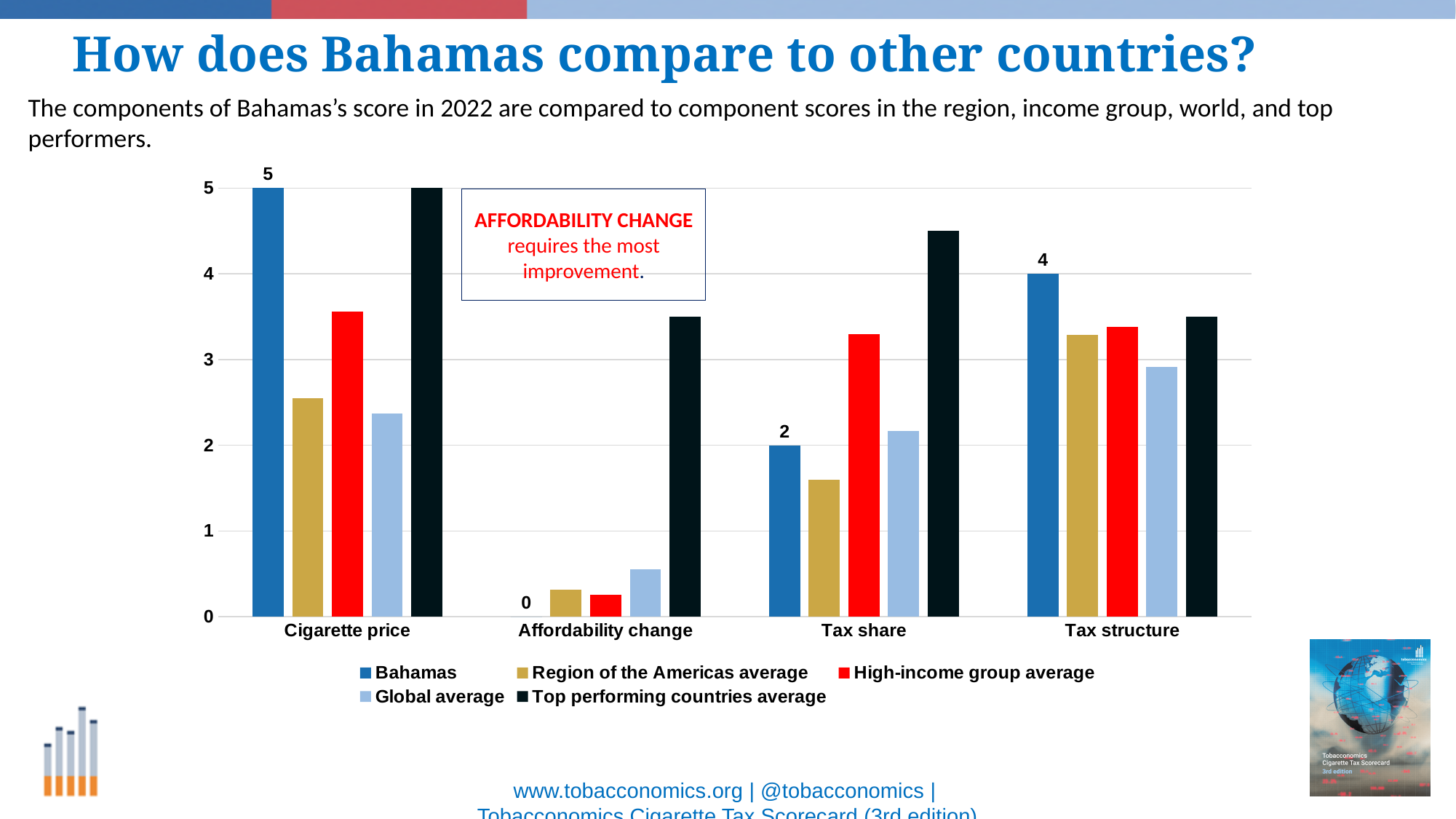
Is the Region of the Americas average for Cigarette price greater or less than 3? less What is the Bahamas score for Affordability change? 0 What kind of chart is shown on the slide? Bar chart Is the Top performing countries average for Tax share greater or less than 4? greater What is the Bahamas score for Tax structure? 4 Which component has the lowest Bahamas score? Affordability change Which component has the highest Bahamas score? Cigarette price What is the Bahamas score for Tax share? 2 What is the Bahamas score for Cigarette price? 5 How many series does the legend list? 5 Which is larger for Bahamas: the Tax structure score or the Tax share score? Tax structure What is the difference between the Bahamas score for Cigarette price and its score for Tax share? 3